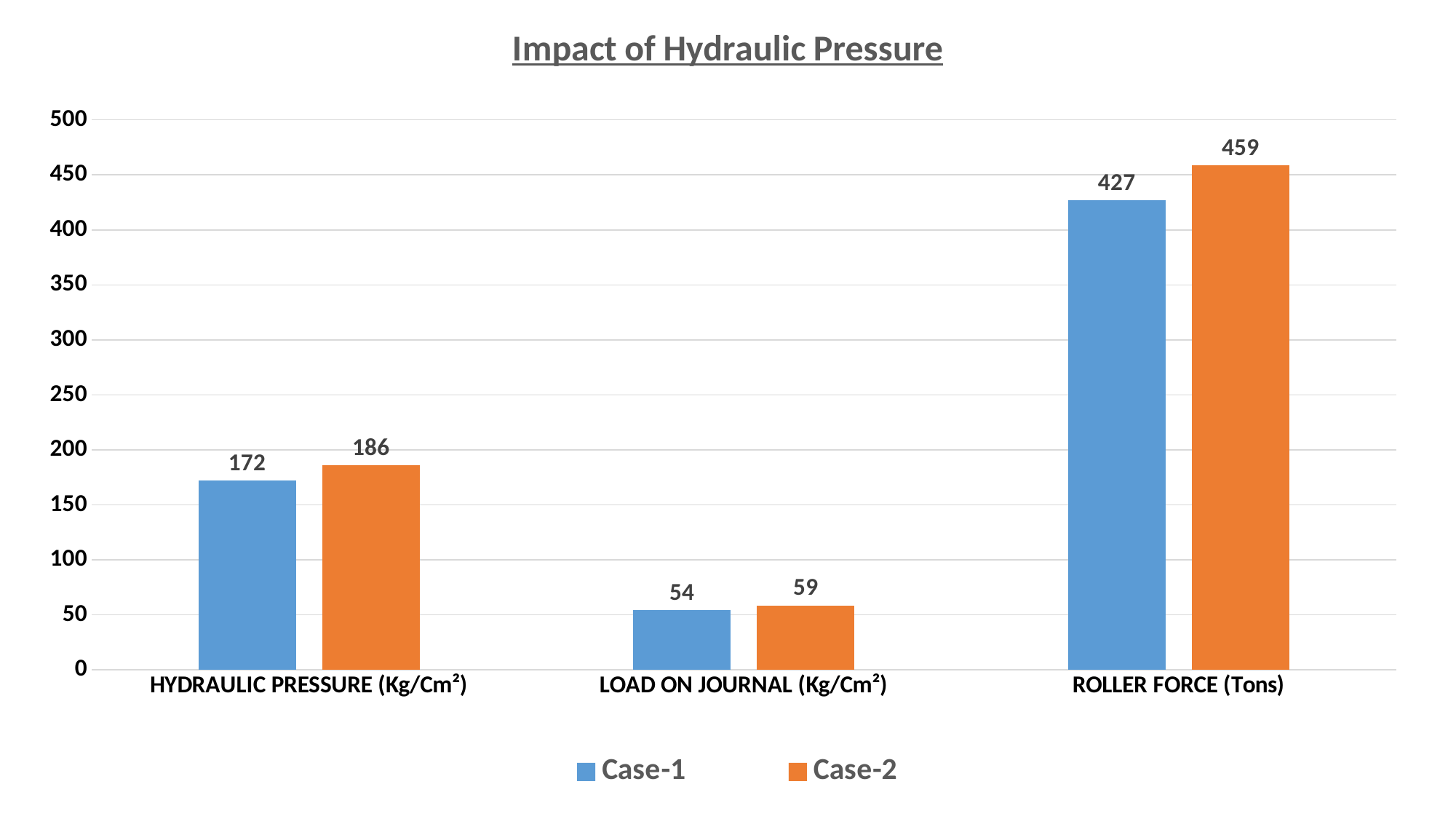
What is the difference between the Case-2 and Case-1 values for ROLLER FORCE (Tons)? 32 Which category has the lowest Case-2 value? LOAD ON JOURNAL (Kg/Cm²) How many categories are shown on the x axis? 3 What is the Case-2 value for ROLLER FORCE (Tons)? 459 What is the Case-1 value for HYDRAULIC PRESSURE (Kg/Cm²)? 172 What is the difference between the Case-2 and Case-1 values for HYDRAULIC PRESSURE (Kg/Cm²)? 14 For LOAD ON JOURNAL (Kg/Cm²), which is larger: Case-1 or Case-2? Case-2 How many series does the legend list? 2 Which category has the highest Case-1 value? ROLLER FORCE (Tons) What is the Case-2 value for LOAD ON JOURNAL (Kg/Cm²)? 59 What kind of chart is shown on the slide? Bar chart Is the Case-1 value for ROLLER FORCE (Tons) greater or less than 400? greater